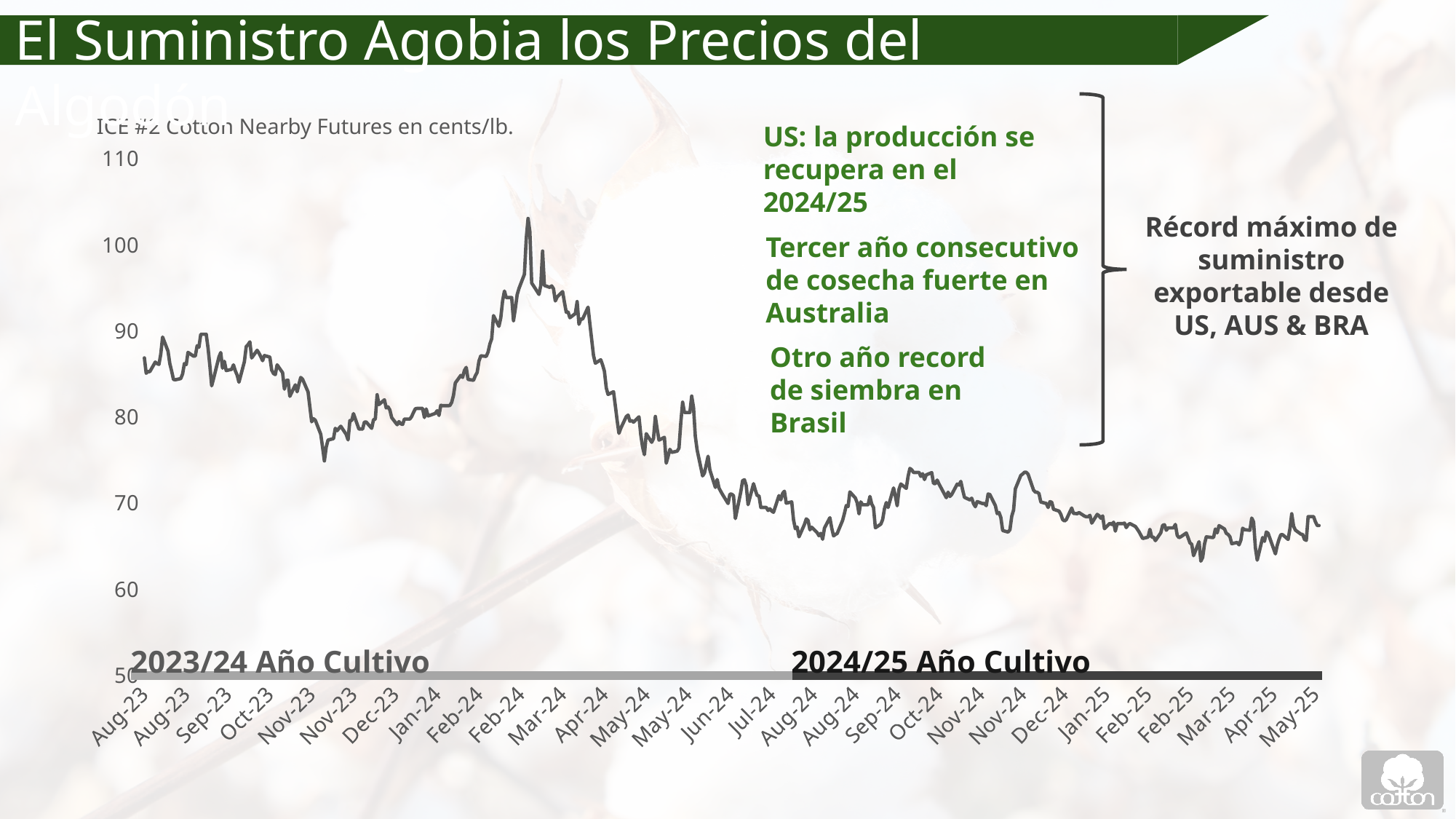
Is the cotton futures price at the end of the series (May-25) greater or less than 70? less How many lines (series) are plotted on the chart? 1 Is the cotton futures price in Jul-24 greater or less than 80? less What is the highest value shown on the vertical axis of the chart? 110 Is the cotton futures price higher in Aug-23 or in May-25? Aug-23 Does the cotton futures price generally rise or fall from Feb-24 to May-25? fall Is the peak value of the cotton futures price in Feb-24 greater or less than 100? greater In which month does the cotton futures price reach its highest peak? Feb-24 What does the chart plot, according to the label above it? ICE #2 Cotton Nearby Futures en cents/lb. What kind of chart is shown on the slide? line chart Which two crop years are labelled along the bottom of the chart? 2023/24 Año Cultivo and 2024/25 Año Cultivo